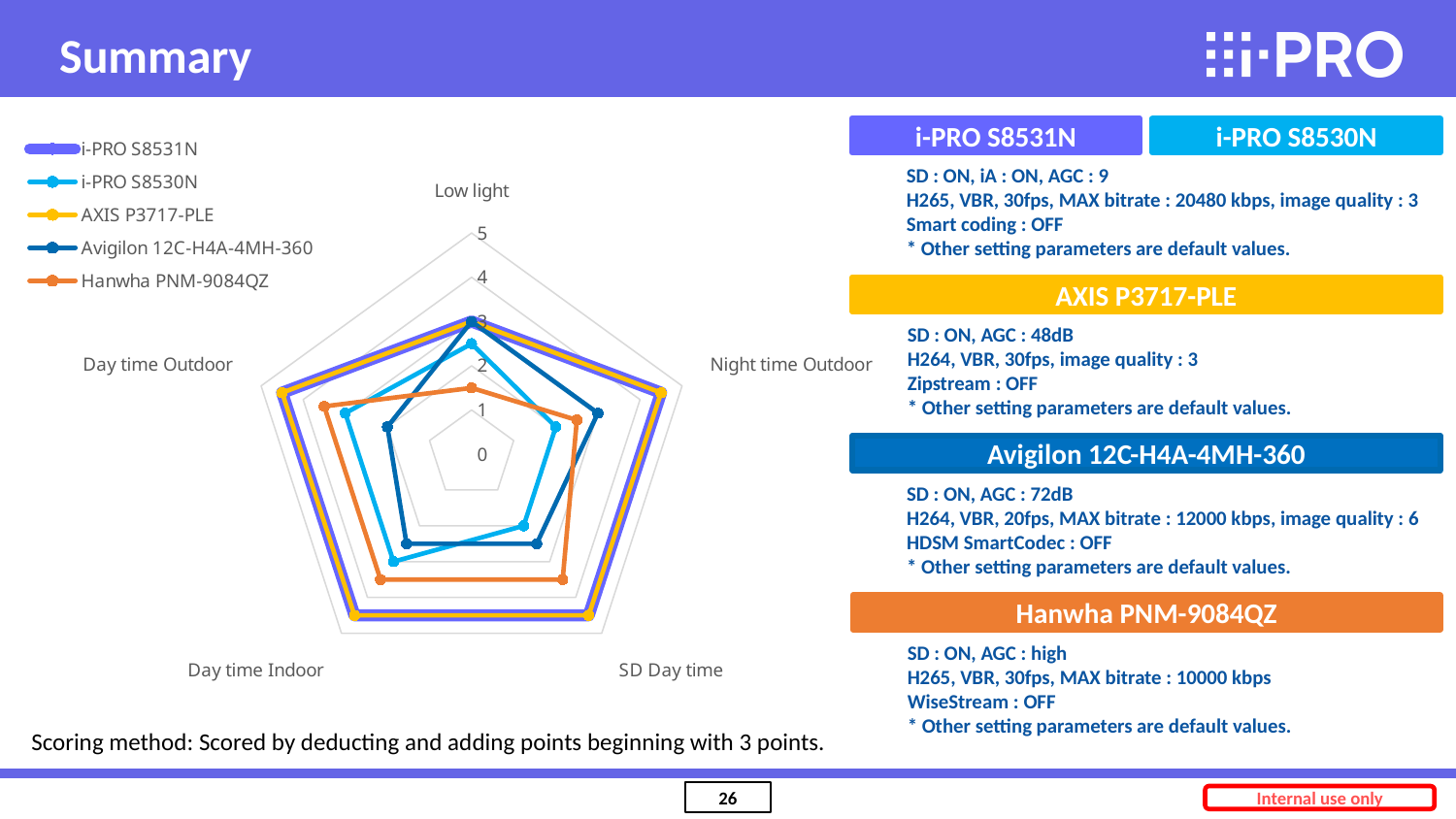
Is the value for AXIS P3717-PLE on the Day time Indoor axis greater or less than 3? greater Is the value for i-PRO S8531N on the Night time Outdoor axis greater or less than 3? greater On the SD Day time axis, which is larger: Hanwha PNM-9084QZ or i-PRO S8530N? Hanwha PNM-9084QZ Is the value for i-PRO S8530N on the SD Day time axis greater or less than 3? less What is the maximum value shown on the radar chart's scale? 5 Which series is shown in orange in the legend? Hanwha PNM-9084QZ How many axes (categories) does the radar chart have? 5 Which series has the lowest value on the Low light axis? Hanwha PNM-9084QZ What kind of chart is shown on the slide? Radar chart On the Night time Outdoor axis, which is larger: i-PRO S8531N or Hanwha PNM-9084QZ? i-PRO S8531N How many series does the chart legend list? 5